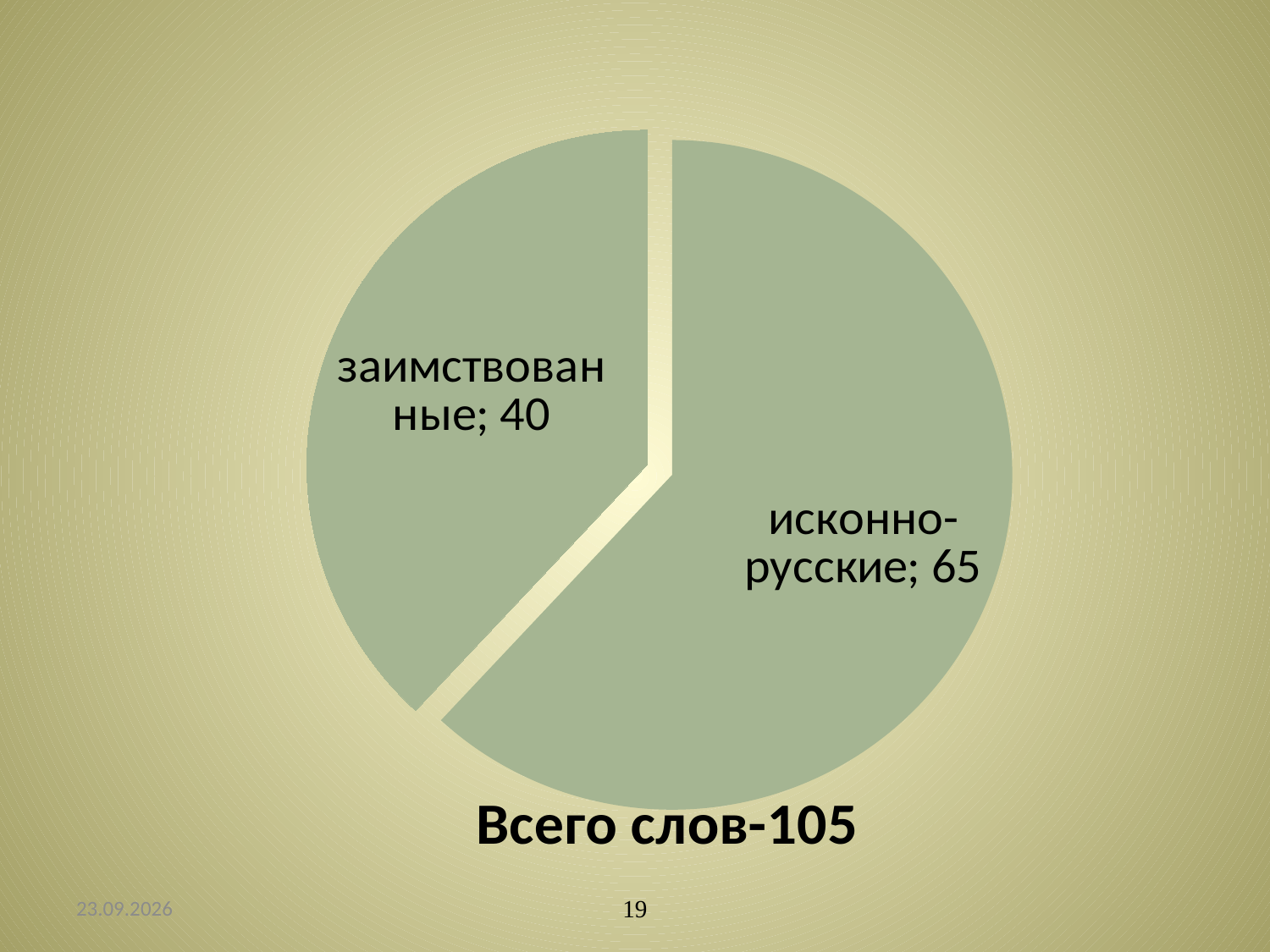
What kind of chart is shown on the slide? pie chart Which slice is the largest? исконно-русские What total number of words is stated below the chart? 105 How many slices does the pie chart have? 2 What is the difference between the "исконно-русские" and "заимствованные" values? 25 Which slice is the smallest? заимствованные What is the value for the "заимствованные" slice? 40 Which is larger, "исконно-русские" or "заимствованные"? исконно-русские What is the total of the two slices? 105 What is the value for the "исконно-русские" slice? 65